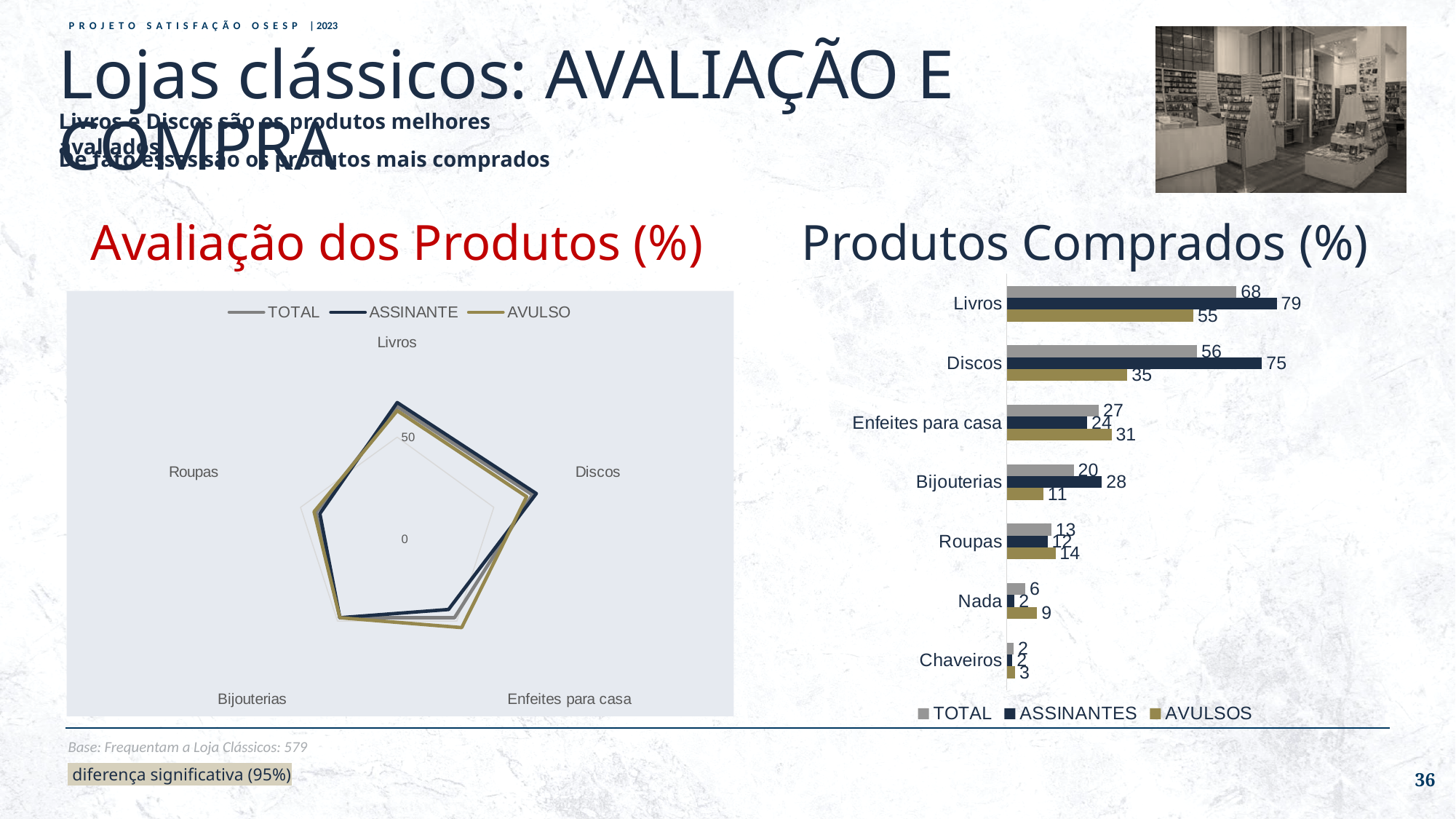
In the 'Produtos Comprados (%)' chart, which category has the highest TOTAL value? Livros In the 'Produtos Comprados (%)' chart, what is the TOTAL value for Enfeites para casa? 27 In the 'Produtos Comprados (%)' chart, what is the difference between the ASSINANTES and AVULSOS values for Discos? 40 In the 'Produtos Comprados (%)' chart, which category has the lowest ASSINANTES value? Nada and Chaveiros (both 2) In the 'Produtos Comprados (%)' chart, what is the ASSINANTES value for Livros? 79 What kind of chart is 'Avaliação dos Produtos (%)'? Radar chart In the 'Produtos Comprados (%)' chart, which is larger for Bijouterias: the ASSINANTES value or the AVULSOS value? ASSINANTES In the 'Avaliação dos Produtos (%)' radar chart, is the ASSINANTE value for Livros greater or less than 50? greater How many categories are shown in the 'Avaliação dos Produtos (%)' radar chart? 5 In the 'Produtos Comprados (%)' chart, what is the AVULSOS value for Discos? 35 How many categories are shown in the 'Produtos Comprados (%)' chart? 7 How many series does the legend of the 'Produtos Comprados (%)' chart list? 3